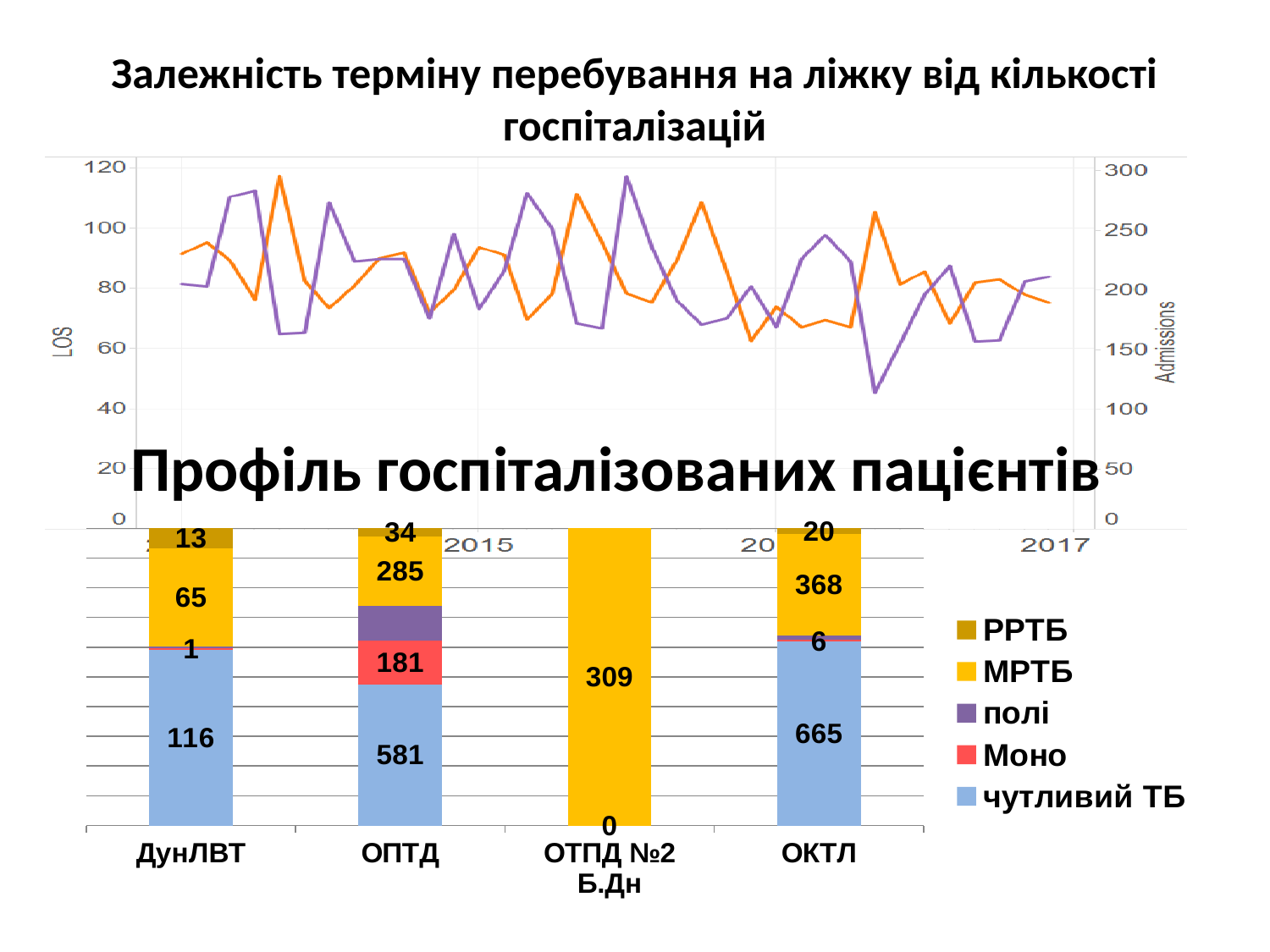
In the bar chart 'Профіль госпіталізованих пацієнтів', how many categories are shown on the x axis? 4 In the bar chart 'Профіль госпіталізованих пацієнтів', which category has the highest value of чутливий ТБ? ОКТЛ In the bar chart 'Профіль госпіталізованих пацієнтів', what is the difference between the МРТБ values for ОКТЛ and ОПТД? 83 In the bar chart 'Профіль госпіталізованих пацієнтів', what is the value of МРТБ for ОТПД №2 Б.Дн? 309 In the bar chart 'Профіль госпіталізованих пацієнтів', which category has the lowest value of чутливий ТБ? ОТПД №2 Б.Дн In the bar chart 'Профіль госпіталізованих пацієнтів', what is the value of МРТБ for ОПТД? 285 In the bar chart 'Профіль госпіталізованих пацієнтів', which has the larger чутливий ТБ value, ОПТД or ОКТЛ? ОКТЛ In the bar chart 'Профіль госпіталізованих пацієнтів', how many series does the legend list? 5 In the bar chart 'Профіль госпіталізованих пацієнтів', what is the value of РРТБ for ДунЛВТ? 13 What kind of chart is the top chart titled 'Залежність терміну перебування на ліжку від кількості госпіталізацій'? line chart In the bar chart 'Профіль госпіталізованих пацієнтів', what is the value of чутливий ТБ for ОКТЛ? 665 In the bar chart 'Профіль госпіталізованих пацієнтів', what is the value of Моно for ОПТД? 181